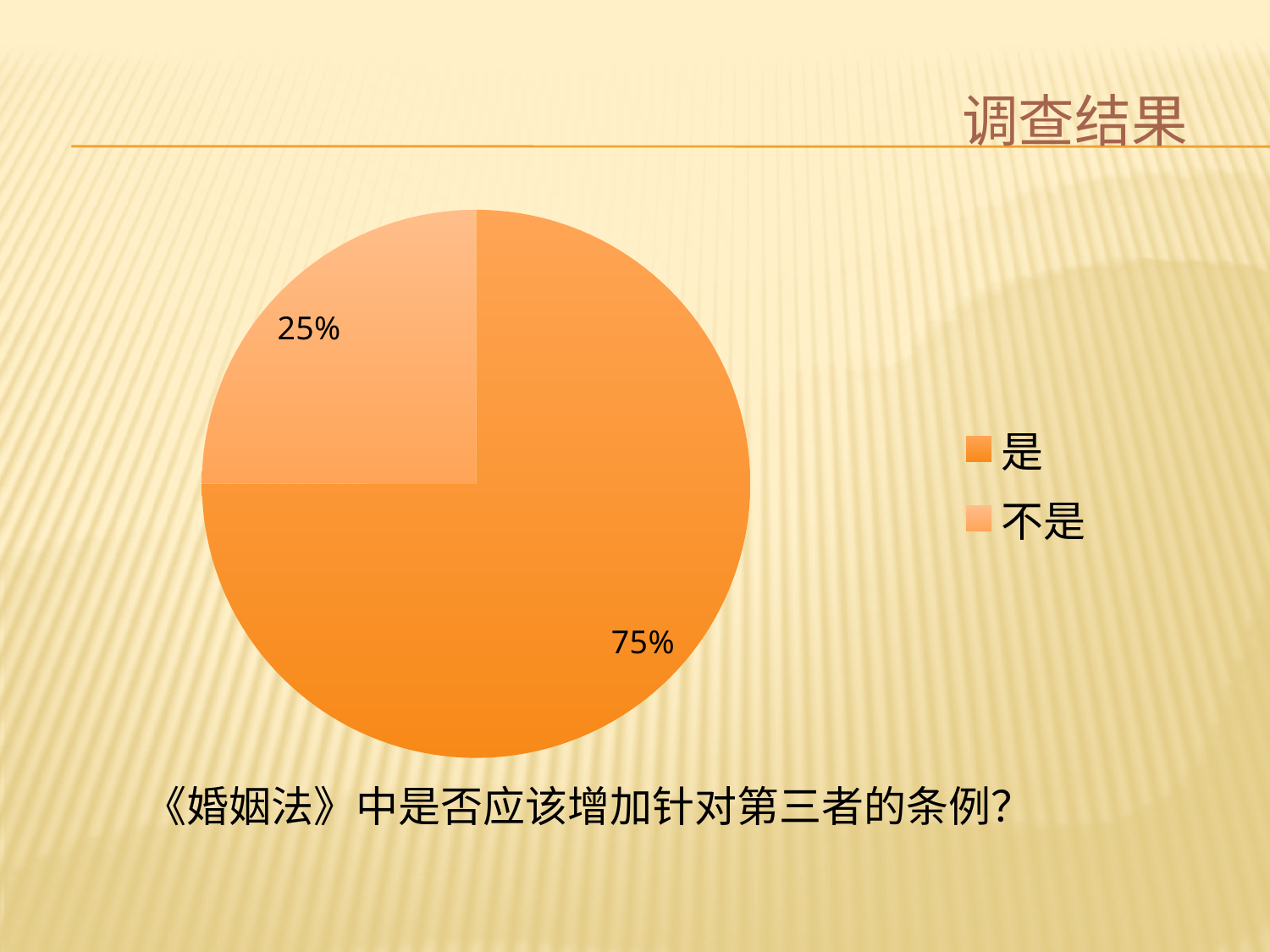
Which category has the largest slice in the pie chart? 是 What percentage of the pie chart is labelled 是? 75% What question is written below the pie chart? 《婚姻法》中是否应该增加针对第三者的条例? What share of the pie does the 不是 slice represent? 25% What percentage of the pie chart is labelled 不是? 25% How many entries does the legend list? 2 What is the title of the slide containing the chart? 调查结果 How many slices does the pie chart have? 2 Which category has the smallest slice in the pie chart? 不是 What kind of chart is shown on the slide? pie chart Which slice is larger, 是 or 不是? 是 What is the difference in percentage points between the 是 slice and the 不是 slice? 50